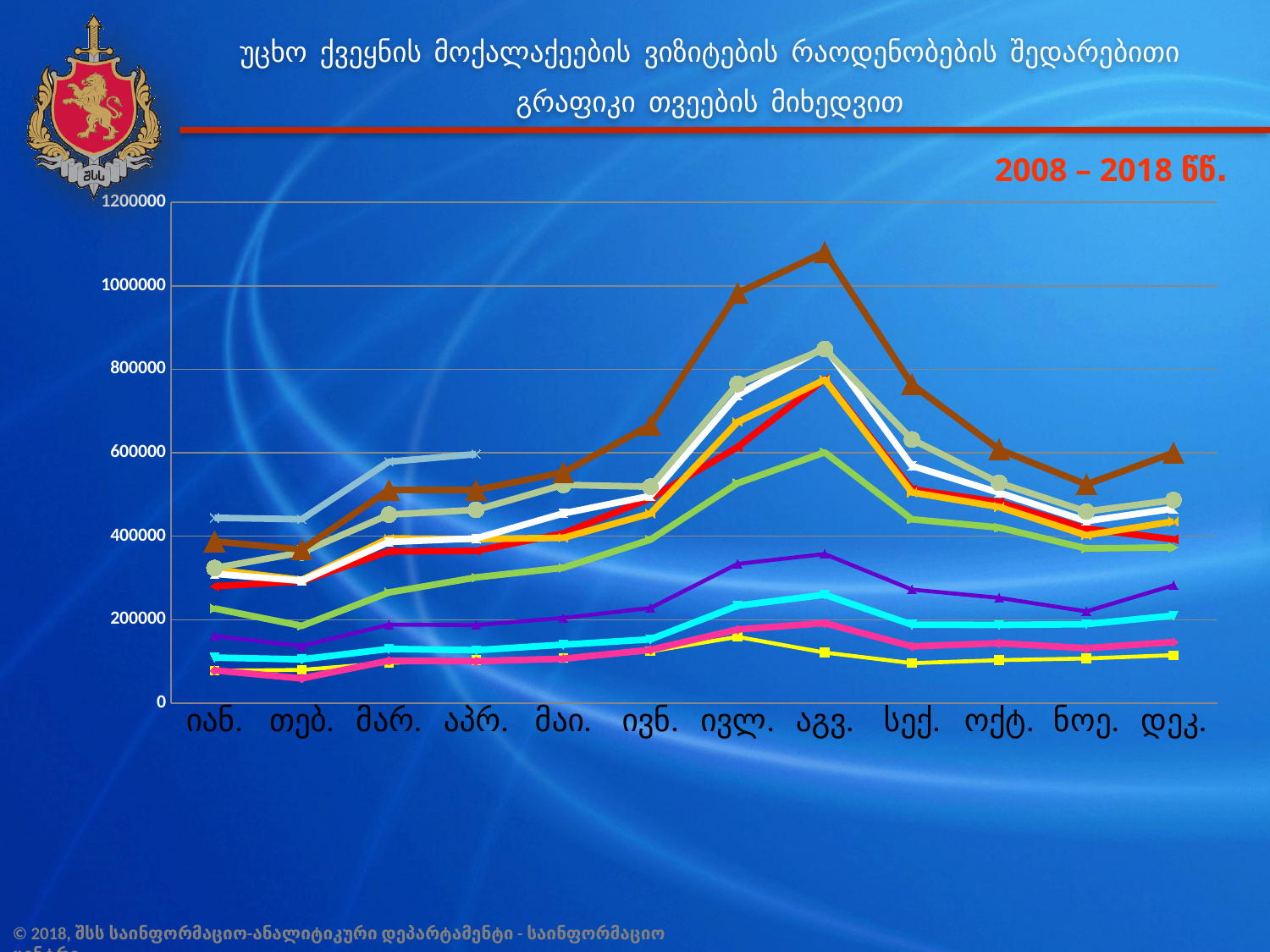
Is the value of the brown line with triangle markers in სექ. greater or less than 600000? greater Does the brown line with triangle markers rise or fall from მაი. to აგვ.? rise Is the value of the brown line with triangle markers in აგვ. greater or less than 1000000? greater Is the value of the yellow line with square markers in აგვ. greater or less than 200000? less Does the brown line with triangle markers rise or fall from აგვ. to ნოე.? fall In აგვ., which is larger: the value of the brown line with triangle markers or the value of the yellow line with square markers? the brown line with triangle markers In which month does the brown line with triangle markers reach its highest value? აგვ. What year range is shown above the chart? 2008 – 2018 წწ. How many months are shown along the x axis of the chart? 12 What is the highest value shown on the y axis of the chart? 1200000 What kind of chart is shown on the slide? line chart